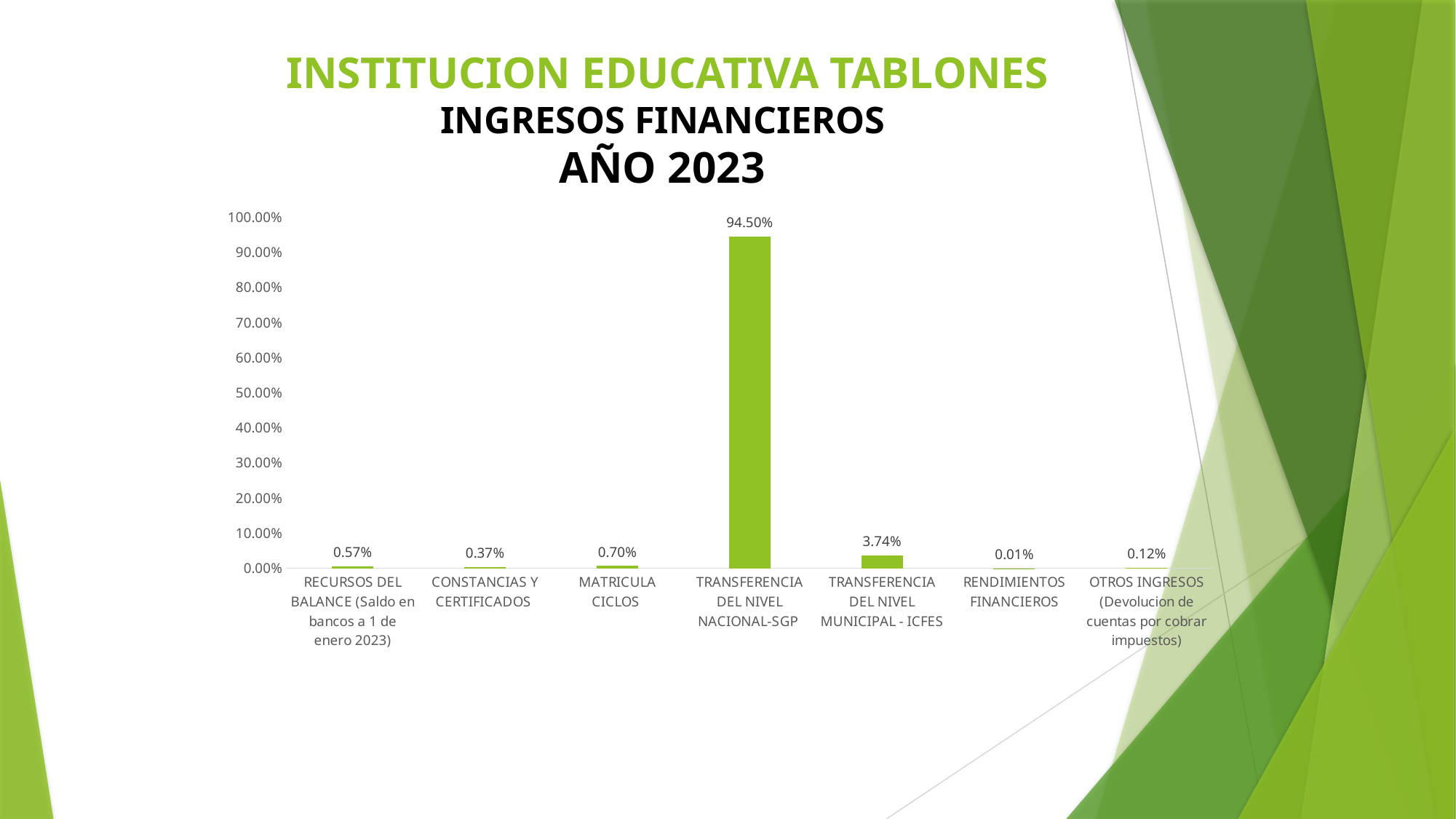
What is the value for TRANSFERENCIA DEL NIVEL MUNICIPAL - ICFES? 3.74% Is the value for TRANSFERENCIA DEL NIVEL NACIONAL-SGP greater or less than 90.00%? greater What is the value for MATRICULA CICLOS? 0.70% What kind of chart is shown on the slide? bar chart What is the value for RENDIMIENTOS FINANCIEROS? 0.01% What is the difference between the values for TRANSFERENCIA DEL NIVEL NACIONAL-SGP and TRANSFERENCIA DEL NIVEL MUNICIPAL - ICFES? 90.76% What year does the chart title refer to? 2023 How many categories are shown on the x axis? 7 Which category has the lowest value? RENDIMIENTOS FINANCIEROS Which category has the highest value? TRANSFERENCIA DEL NIVEL NACIONAL-SGP What is the value for TRANSFERENCIA DEL NIVEL NACIONAL-SGP? 94.50% Which is larger, the value for RECURSOS DEL BALANCE or the value for CONSTANCIAS Y CERTIFICADOS? RECURSOS DEL BALANCE